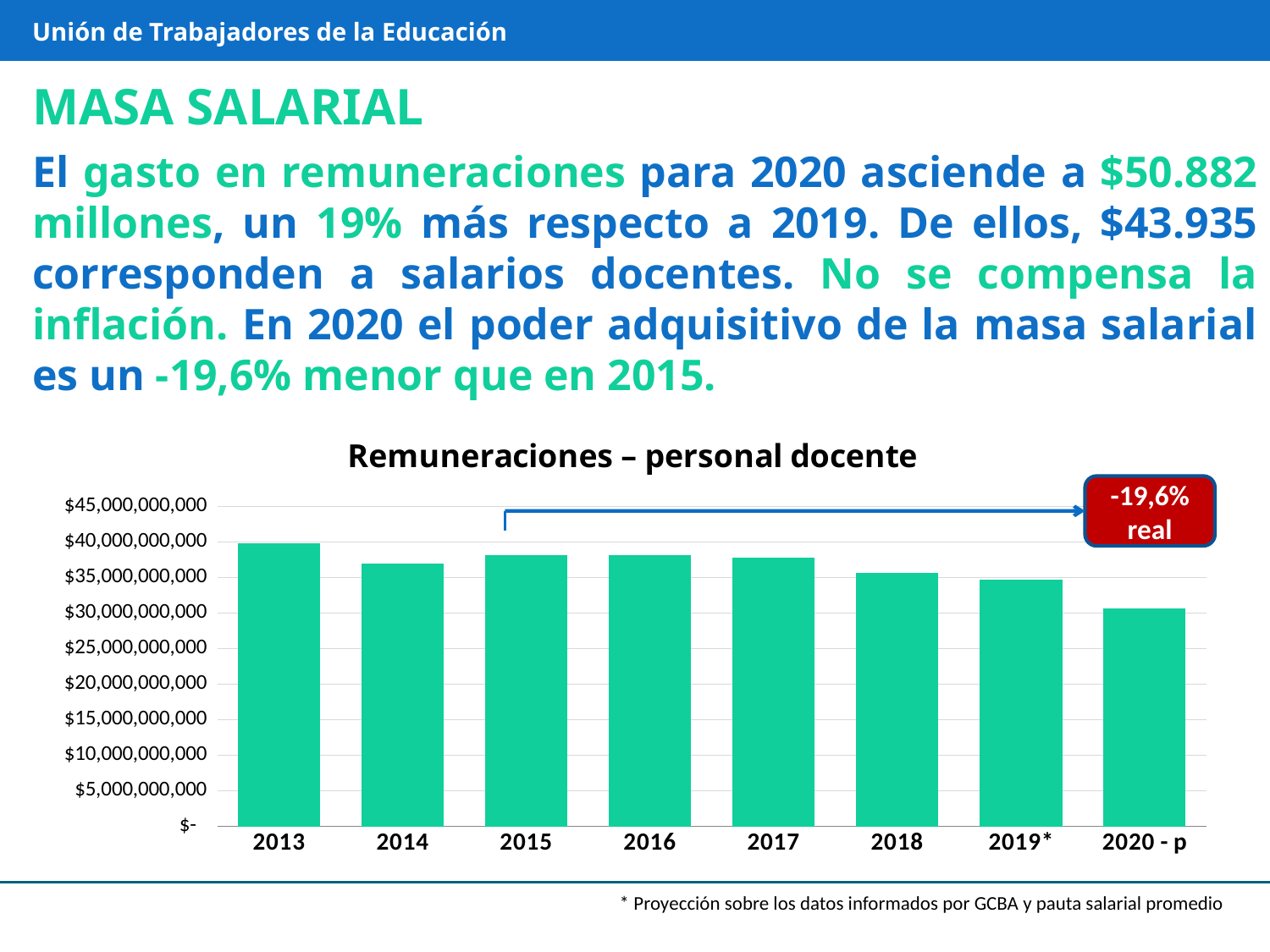
Do the values generally rise or fall from 2013 to 2020 - p? Fall Is the value for 2019* greater or less than $40,000,000,000? less Which is larger, the value for 2013 or the value for 2014? 2013 Is the value for 2013 greater or less than $35,000,000,000? greater What does the red label above the chart say? -19,6% real What is the title of the chart? Remuneraciones – personal docente How many years (categories) are plotted on the chart? 8 Is the value for 2020 - p greater or less than $35,000,000,000? less Which year has the highest bar in the chart? 2013 Which is larger, the value for 2018 or the value for 2020 - p? 2018 What kind of chart is shown on the slide? Bar chart Which year has the lowest bar in the chart? 2020 - p